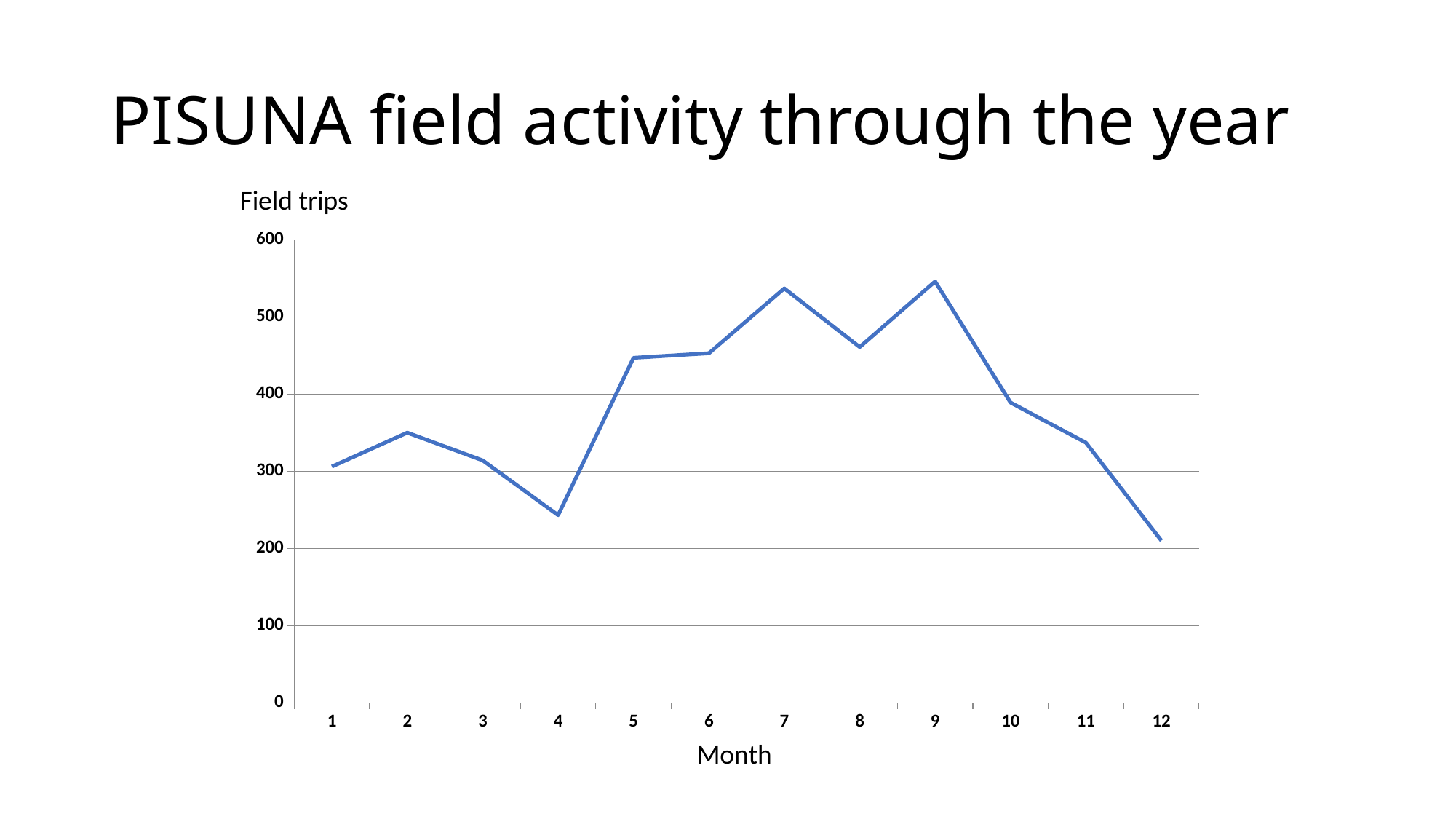
What kind of chart is shown on the slide? line chart Is the value for month 8 greater or less than 500? less Which month has the lowest number of field trips? 12 What is the label on the vertical axis of the chart? Field trips Which has more field trips, month 5 or month 4? month 5 Which has more field trips, month 2 or month 3? month 2 Is the value for month 7 greater or less than 500? greater How many months are plotted on the x axis? 12 Is the value for month 11 greater or less than 400? less Do the values rise or fall from month 9 to month 12? fall